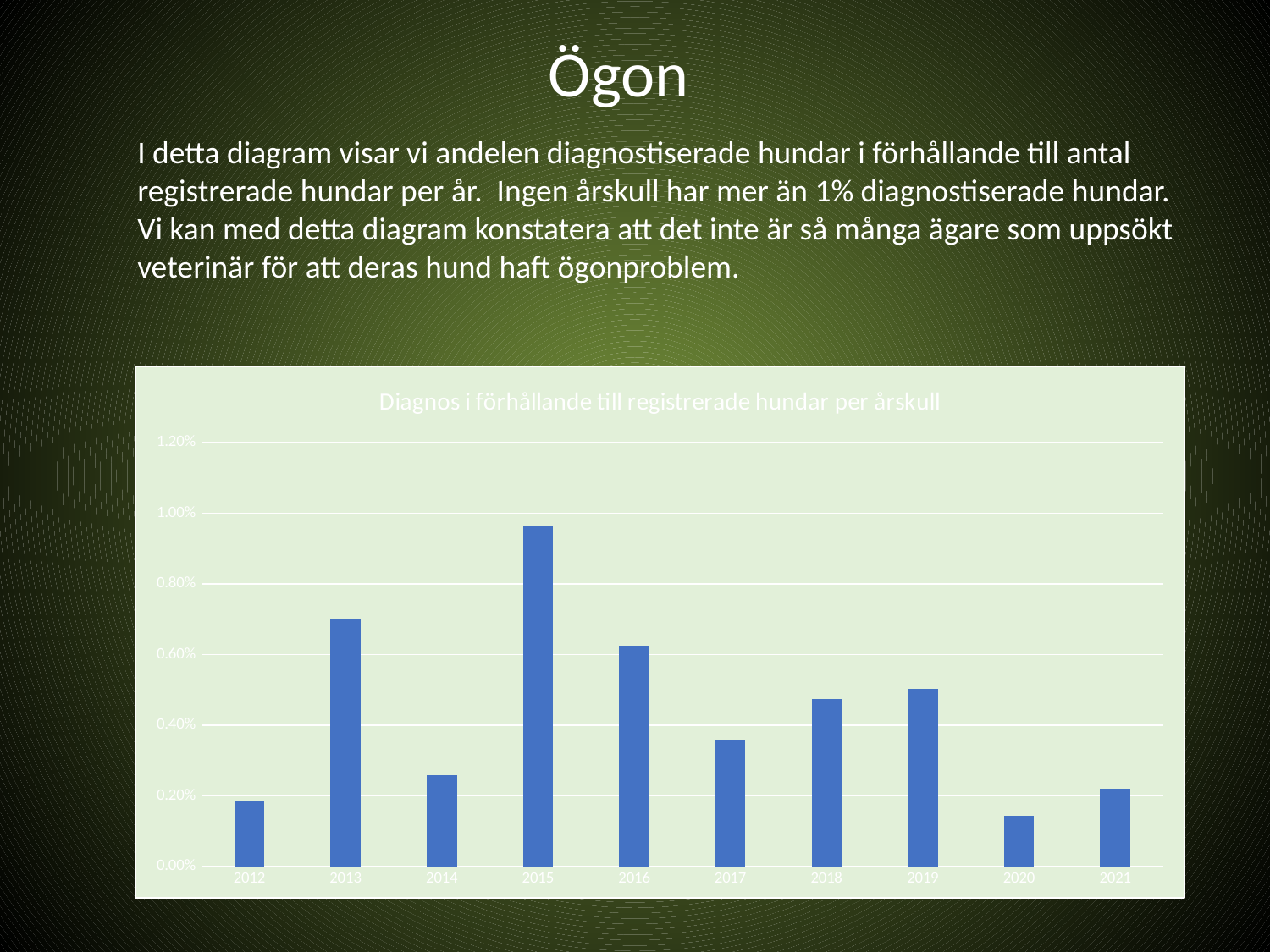
Which year has the highest value in the chart? 2015 Which year has the larger value, 2013 or 2016? 2013 Is the value for 2015 greater or less than 0.80%? greater Is the value for 2013 greater or less than 0.60%? greater Which year has the lowest value in the chart? 2020 Is the value for 2018 greater or less than 0.40%? greater What is the title of the chart? Diagnos i förhållande till registrerade hundar per årskull What kind of chart is shown on the slide? bar chart Does the value rise or fall from 2015 to 2016? fall How many years are shown on the x axis of the chart? 10